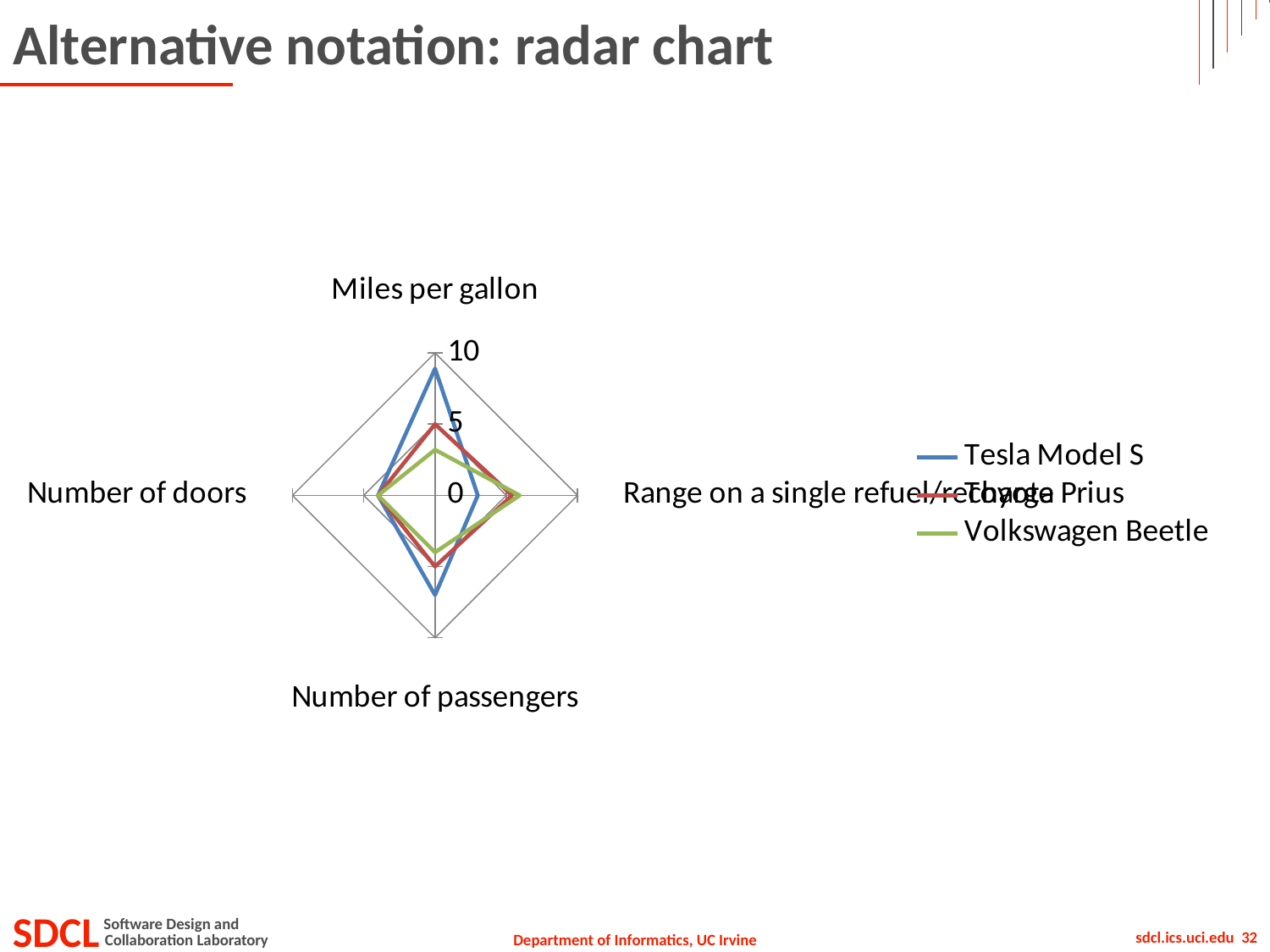
Which is larger: the Miles per gallon value for Tesla Model S or for Volkswagen Beetle? Tesla Model S What colour is the line for Tesla Model S in the legend? Blue Is the Miles per gallon value for Tesla Model S greater or less than 5? greater What kind of chart is shown on the slide? Radar chart How many axes (categories) does the radar chart have? 4 Which car has the highest value for Miles per gallon? Tesla Model S Which car has the highest value for Number of passengers? Tesla Model S Which car has the lowest value for Miles per gallon? Volkswagen Beetle How many series does the legend list? 3 Is the Miles per gallon value for Volkswagen Beetle greater or less than 5? less Is the Number of passengers value for Tesla Model S greater or less than 5? greater Which is larger: the Number of passengers value for Tesla Model S or for Volkswagen Beetle? Tesla Model S